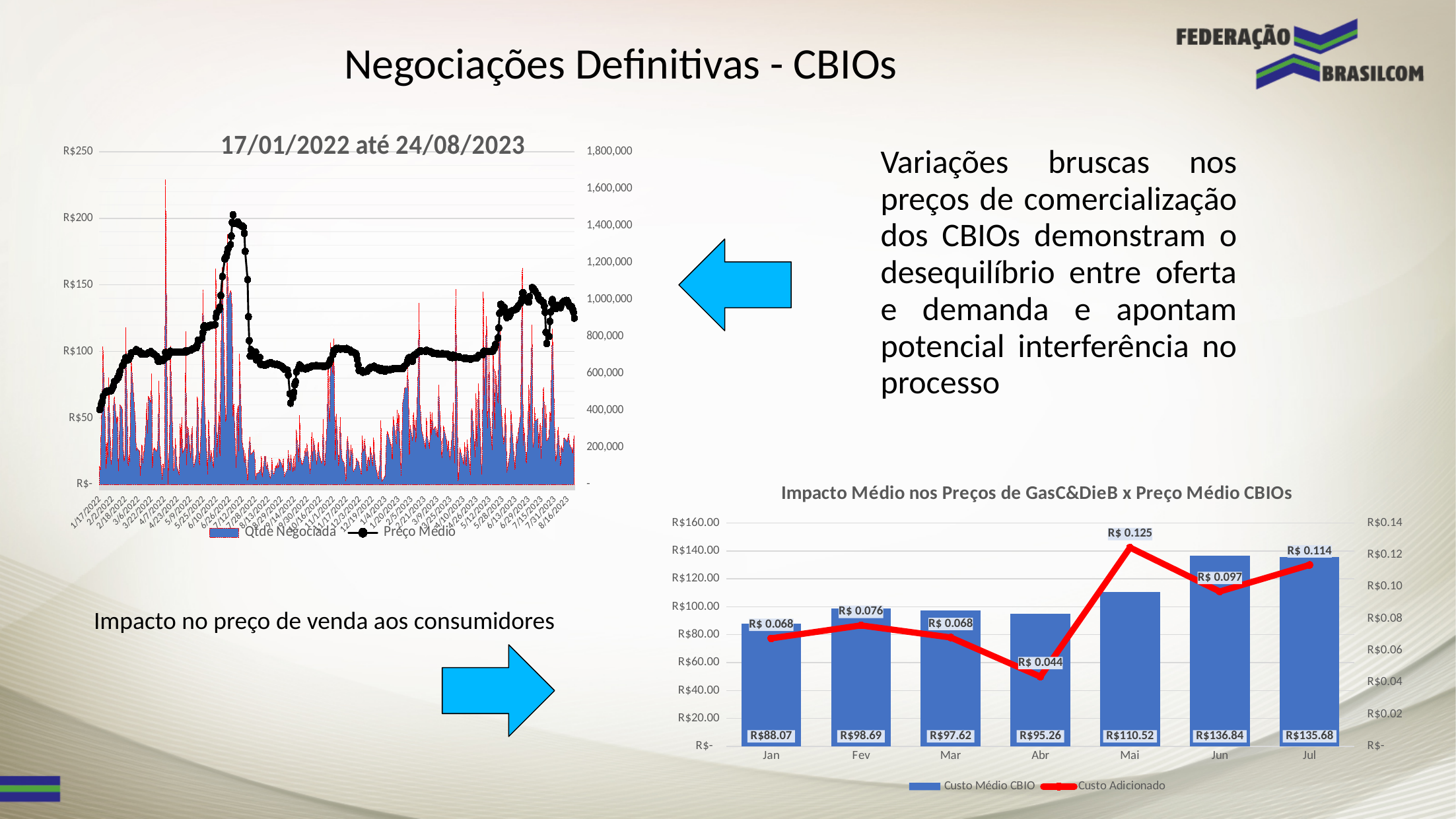
In the chart titled "17/01/2022 até 24/08/2023", how many series does the legend list? 2 In the chart titled "Impacto Médio nos Preços de GasC&DieB x Preço Médio CBIOs", is the Custo Médio CBIO for Mai greater or less than R$100.00? greater In the chart titled "Impacto Médio nos Preços de GasC&DieB x Preço Médio CBIOs", which is larger, the Custo Adicionado for Fev or for Mar? Fev In the chart titled "Impacto Médio nos Preços de GasC&DieB x Preço Médio CBIOs", which month has the highest Custo Médio CBIO? Jun In the chart titled "Impacto Médio nos Preços de GasC&DieB x Preço Médio CBIOs", what is the Custo Médio CBIO value for Jun? R$136.84 In the chart titled "Impacto Médio nos Preços de GasC&DieB x Preço Médio CBIOs", what is the Custo Adicionado value for Abr? R$ 0.044 In the chart titled "Impacto Médio nos Preços de GasC&DieB x Preço Médio CBIOs", which month has the highest Custo Adicionado? Mai In the chart titled "Impacto Médio nos Preços de GasC&DieB x Preço Médio CBIOs", how many months are shown on the x axis? 7 In the chart titled "Impacto Médio nos Preços de GasC&DieB x Preço Médio CBIOs", how many series does the legend list? 2 In the chart titled "17/01/2022 até 24/08/2023", is the peak value of the Preço Médio line greater or less than R$150? greater In the chart titled "Impacto Médio nos Preços de GasC&DieB x Preço Médio CBIOs", what is the difference between the Custo Médio CBIO for Jun and for Jan? R$48.77 In the chart titled "Impacto Médio nos Preços de GasC&DieB x Preço Médio CBIOs", which month has the lowest Custo Médio CBIO? Jan